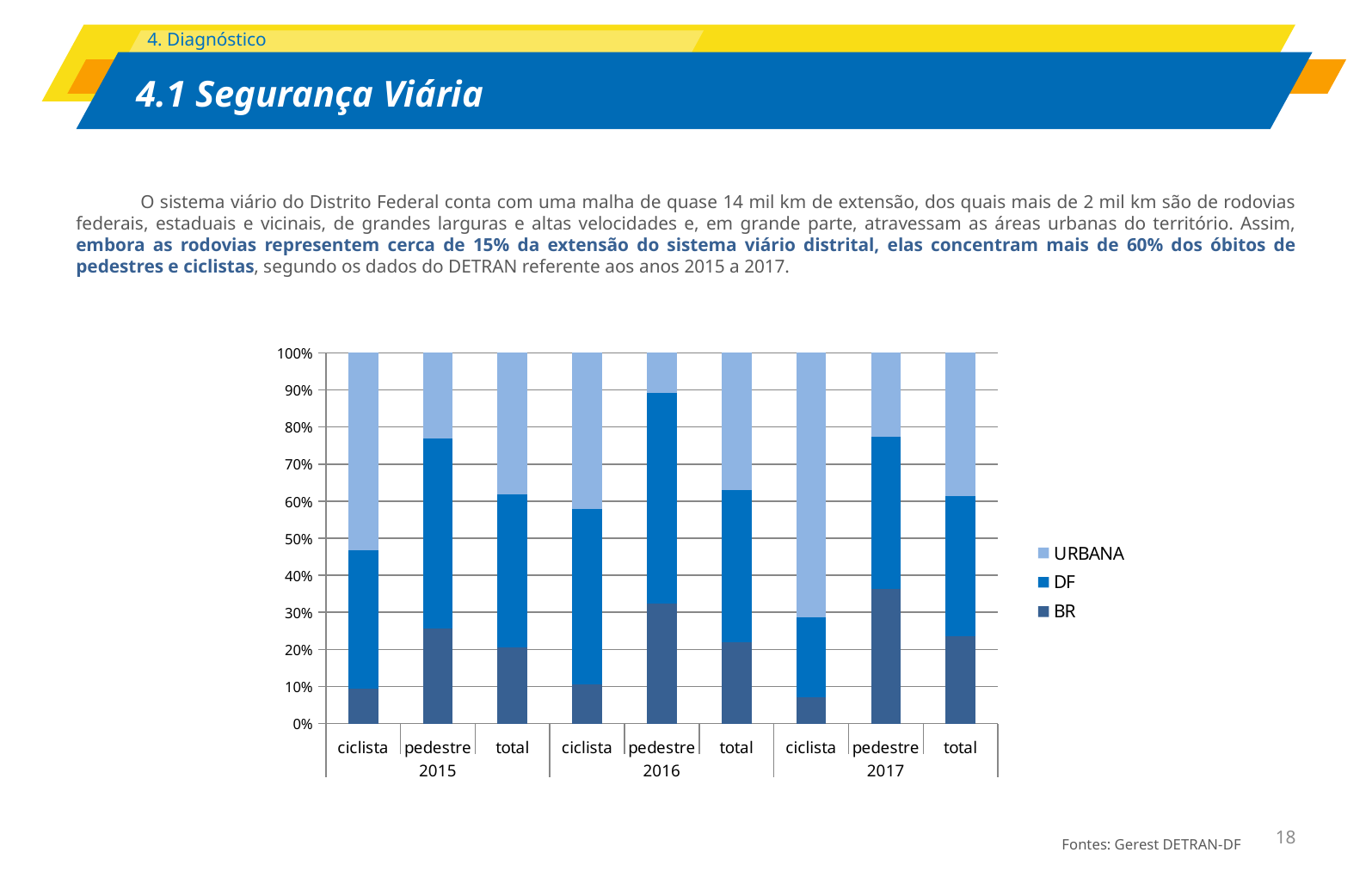
Which bar has the largest URBANA segment? ciclista 2017 Is the BR share for ciclista in 2017 greater or less than 10%? less Is the BR share for pedestre in 2017 greater or less than 30%? greater Is the URBANA share for pedestre in 2016 greater or less than 20%? less Which years are shown along the x axis of the chart? 2015, 2016, 2017 In 2015, which has the larger BR segment: ciclista or pedestre? pedestre Which bar has the smallest URBANA segment? pedestre 2016 What are the series names listed in the chart legend? URBANA, DF, BR What kind of chart is shown on the slide? Stacked bar chart How many series does the chart legend list? 3 How many bars are plotted in the chart? 9